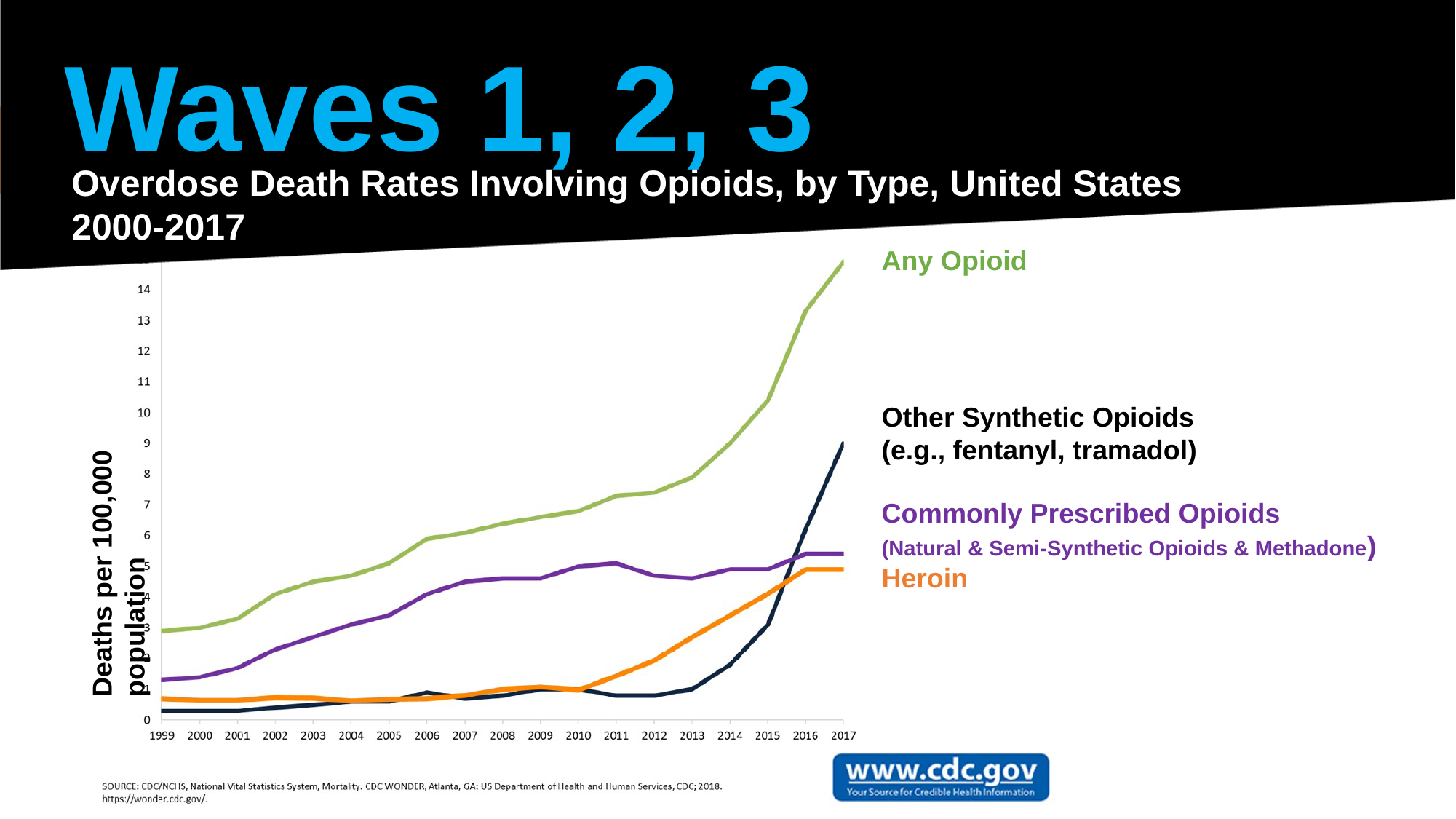
Is the value for Commonly Prescribed Opioids in 2017 greater or less than 6? less Is the value for Heroin in 2010 greater or less than 2? less Which series has the highest value in 2017? Any Opioid Which series has the lowest value in 1999? Other Synthetic Opioids Is the value for Other Synthetic Opioids in 2017 greater or less than 8? greater In 2013, which is larger: the value for Heroin or the value for Other Synthetic Opioids? Heroin What is the label on the y axis of the chart? Deaths per 100,000 population How many years are shown along the x axis of the chart? 19 Does the Any Opioid line rise or fall from 1999 to 2017? rise How many series are labelled on the chart? 4 What kind of chart is shown on the slide? line chart